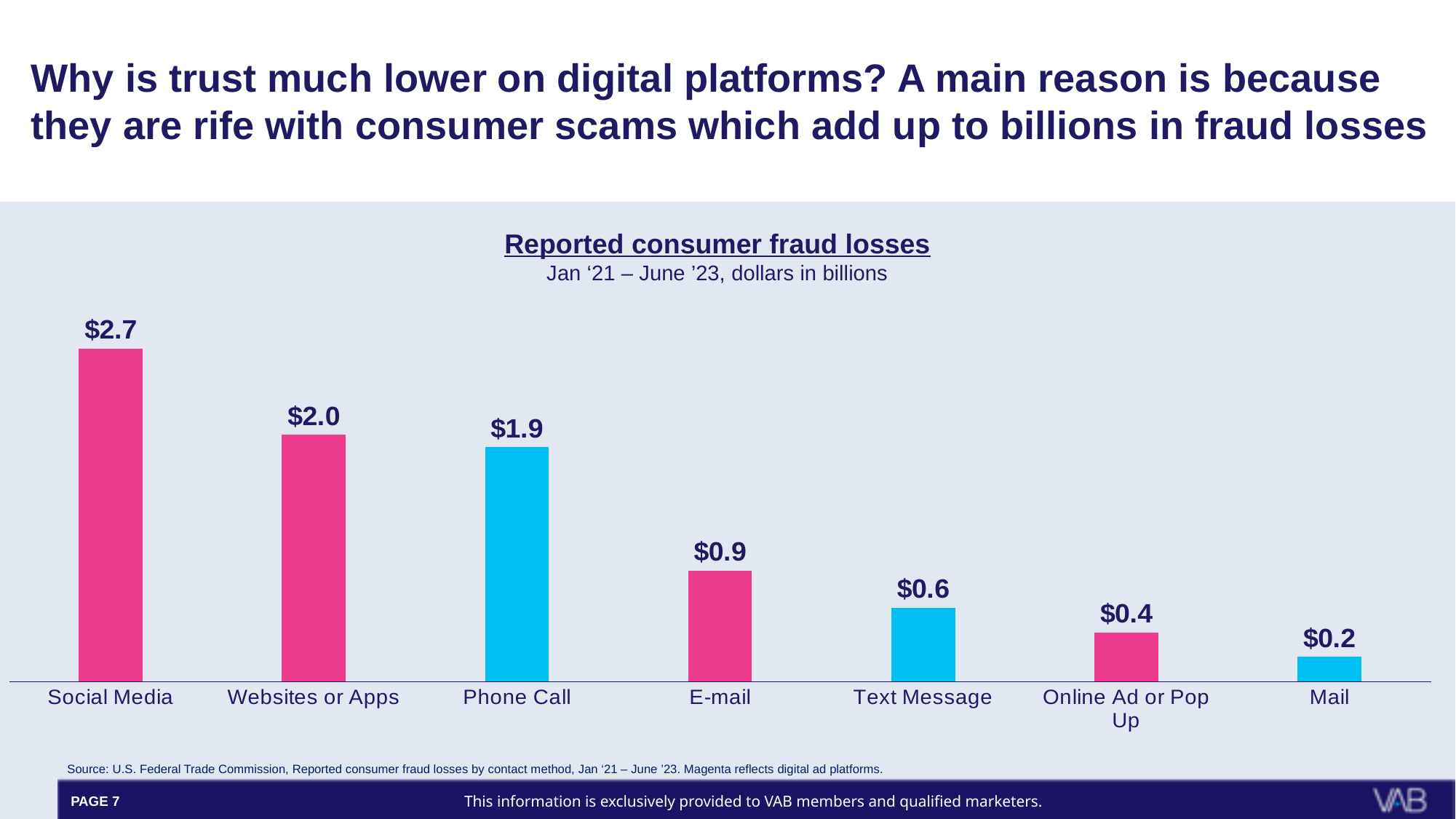
What is the reported consumer fraud loss for Phone Call? $1.9 What is the reported consumer fraud loss for Online Ad or Pop Up? $0.4 What kind of chart is shown on the slide? Bar chart Which has higher reported fraud losses, Websites or Apps or Phone Call? Websites or Apps What is the reported consumer fraud loss for Social Media? $2.7 Do the values rise or fall moving from left to right across the chart? Fall What is the title of the chart? Reported consumer fraud losses Which contact method has the highest reported consumer fraud losses? Social Media Which contact method has the lowest reported consumer fraud losses? Mail What is the difference in reported fraud losses between E-mail and Text Message? $0.3 What is the difference in reported fraud losses between Social Media and Websites or Apps? $0.7 How many contact methods are shown in the chart? 7